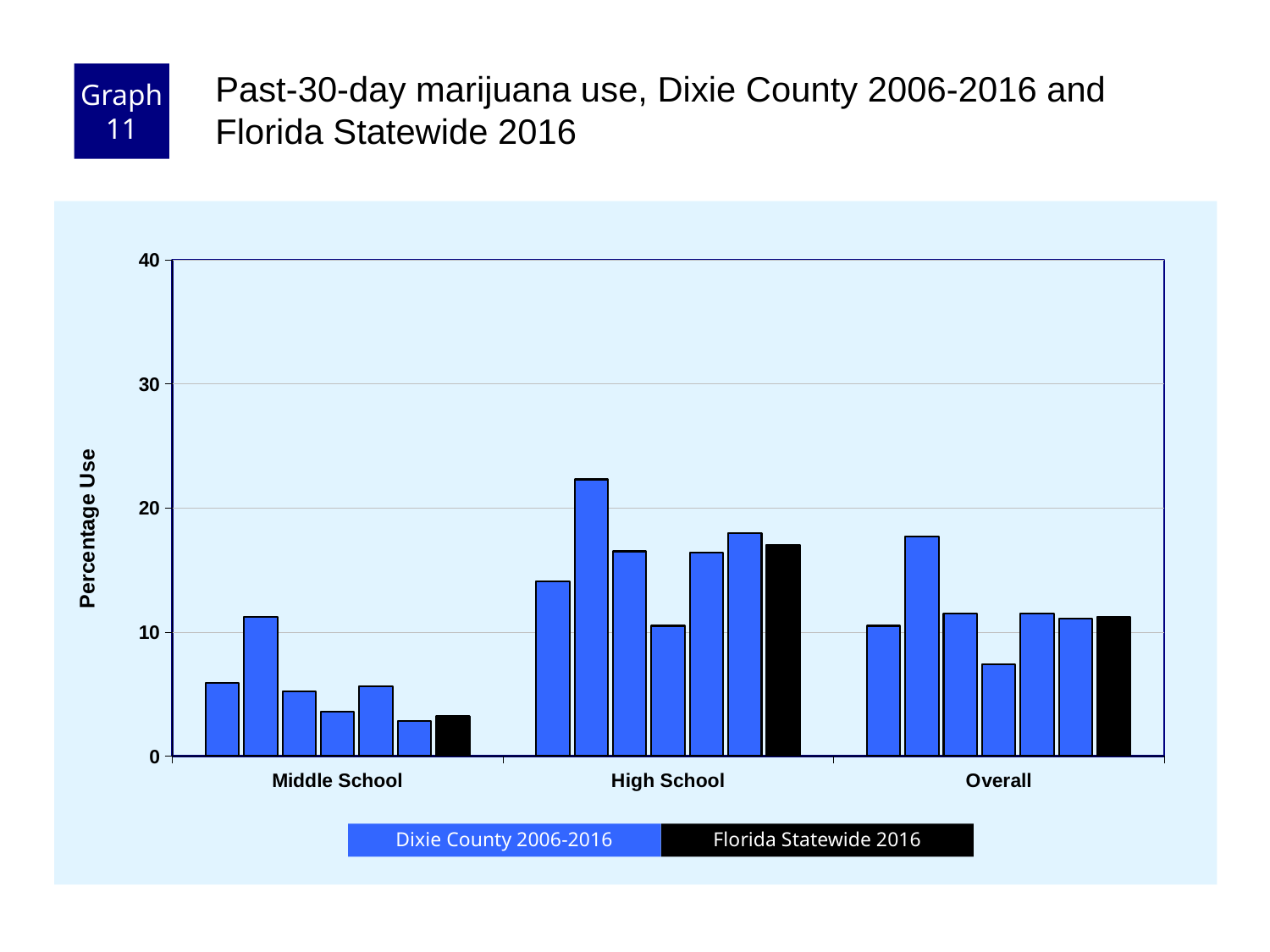
In which category is the Florida Statewide 2016 bar the lowest? Middle School Is the Florida Statewide 2016 value for Overall greater or less than 20? less What kind of chart is shown on the slide? bar chart What are the three categories on the x axis? Middle School, High School, Overall Is the Florida Statewide 2016 value for High School greater or less than 10? greater How many series does the legend list? 2 Is the tallest Dixie County 2006-2016 bar for High School greater or less than 20? greater In which category is the Florida Statewide 2016 bar the highest? High School How many school-level categories are shown on the x axis? 3 Which is larger, the Florida Statewide 2016 value for High School or for Overall? High School What is the label of the y axis? Percentage Use